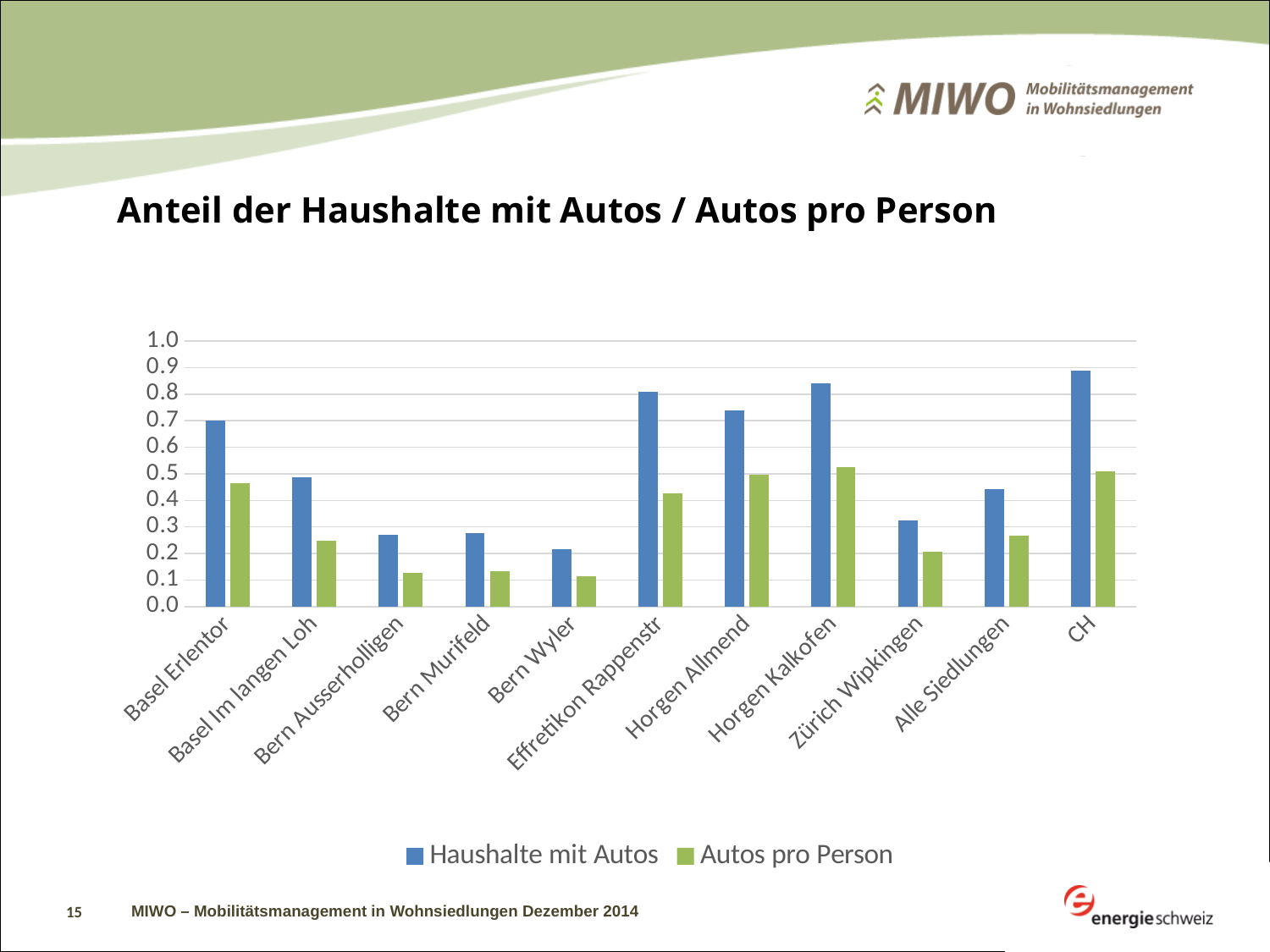
Which has the larger value for Haushalte mit Autos, Effretikon Rappenstr or Horgen Allmend? Effretikon Rappenstr Which has the larger value for Autos pro Person, Basel Erlentor or Zürich Wipkingen? Basel Erlentor Which category has the lowest value for Haushalte mit Autos? Bern Wyler Is the value for Haushalte mit Autos at Zürich Wipkingen greater or less than 0.4? less What kind of chart is shown on the slide? bar chart What is the title of the chart? Anteil der Haushalte mit Autos / Autos pro Person How many series does the legend list? 2 How many categories are shown on the x axis? 11 Is the value for Haushalte mit Autos at Basel Erlentor greater or less than 0.6? greater Is the value for Autos pro Person at Horgen Allmend greater or less than 0.4? greater Which category has the highest value for Haushalte mit Autos? CH